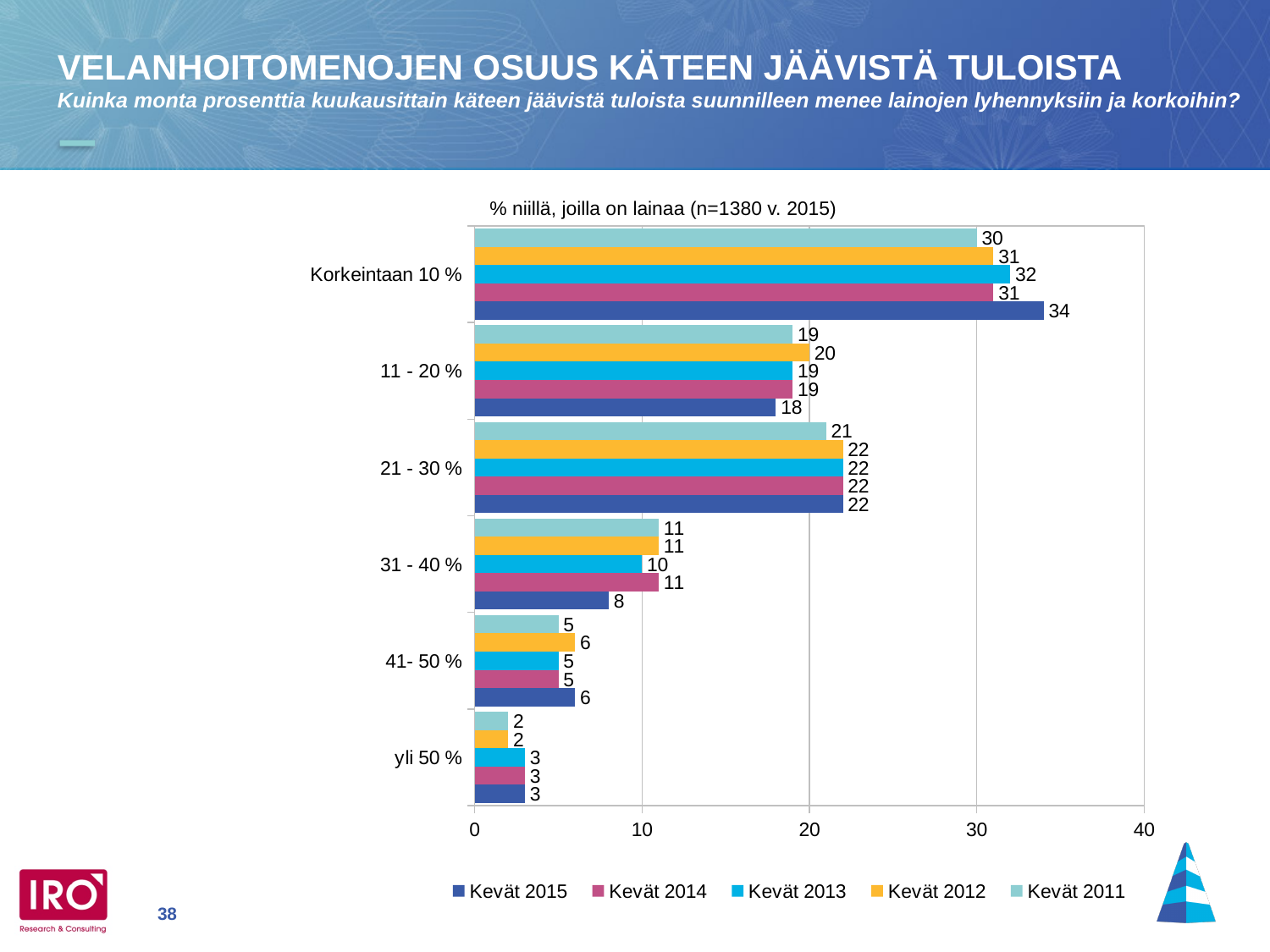
Is the value for Kevät 2013 in the category '21 - 30 %' greater or less than 20? greater What is the subtitle printed above the chart? % niillä, joilla on lainaa (n=1380 v. 2015) How many categories are shown on the vertical axis? 6 How many series does the legend list? 5 In the category '31 - 40 %', which is larger: the value for Kevät 2014 or the value for Kevät 2015? Kevät 2014 What is the difference between the Kevät 2015 and Kevät 2011 values in the category 'Korkeintaan 10 %'? 4 What kind of chart is shown on the slide? Bar chart Which category has the lowest value for Kevät 2011? yli 50 % What is the value for Kevät 2012 in the category '11 - 20 %'? 20 What is the value for Kevät 2013 in the category '31 - 40 %'? 10 What is the value for Kevät 2015 in the category 'Korkeintaan 10 %'? 34 Which category has the highest value for Kevät 2015? Korkeintaan 10 %